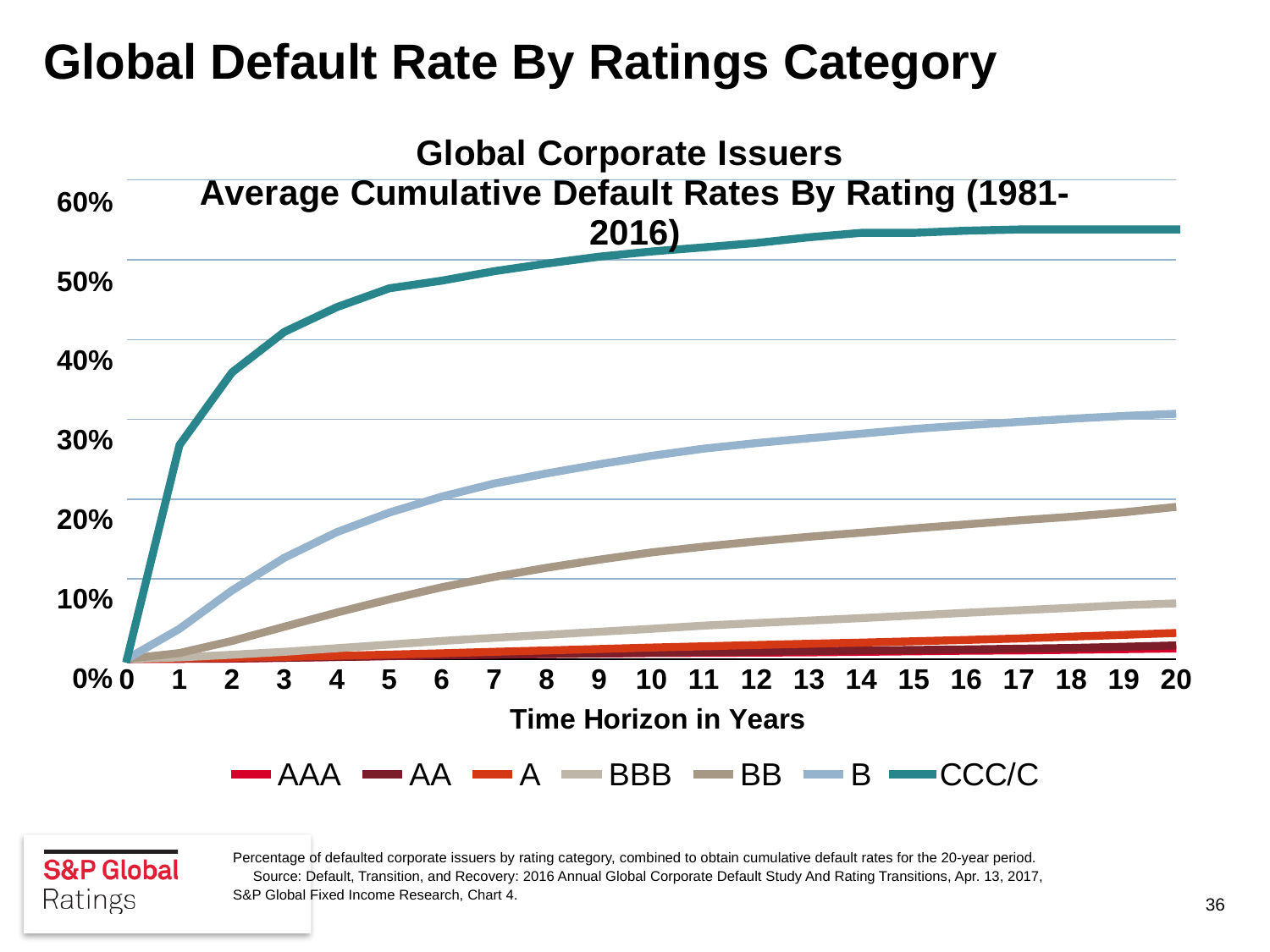
What is the first line of the chart title? Global Corporate Issuers Is the cumulative default rate for BB at year 10 greater or less than 10%? greater Do the cumulative default rates for CCC/C rise or fall as the time horizon increases? rise Which rating category has the highest cumulative default rate at year 20? CCC/C Is the cumulative default rate for CCC/C at year 20 greater or less than 50%? greater How many series does the legend list? 7 At year 20, which has the higher cumulative default rate, B or BB? B Is the cumulative default rate for BBB at year 20 greater or less than 10%? less What is the label of the x axis? Time Horizon in Years What kind of chart is shown on the slide? line chart